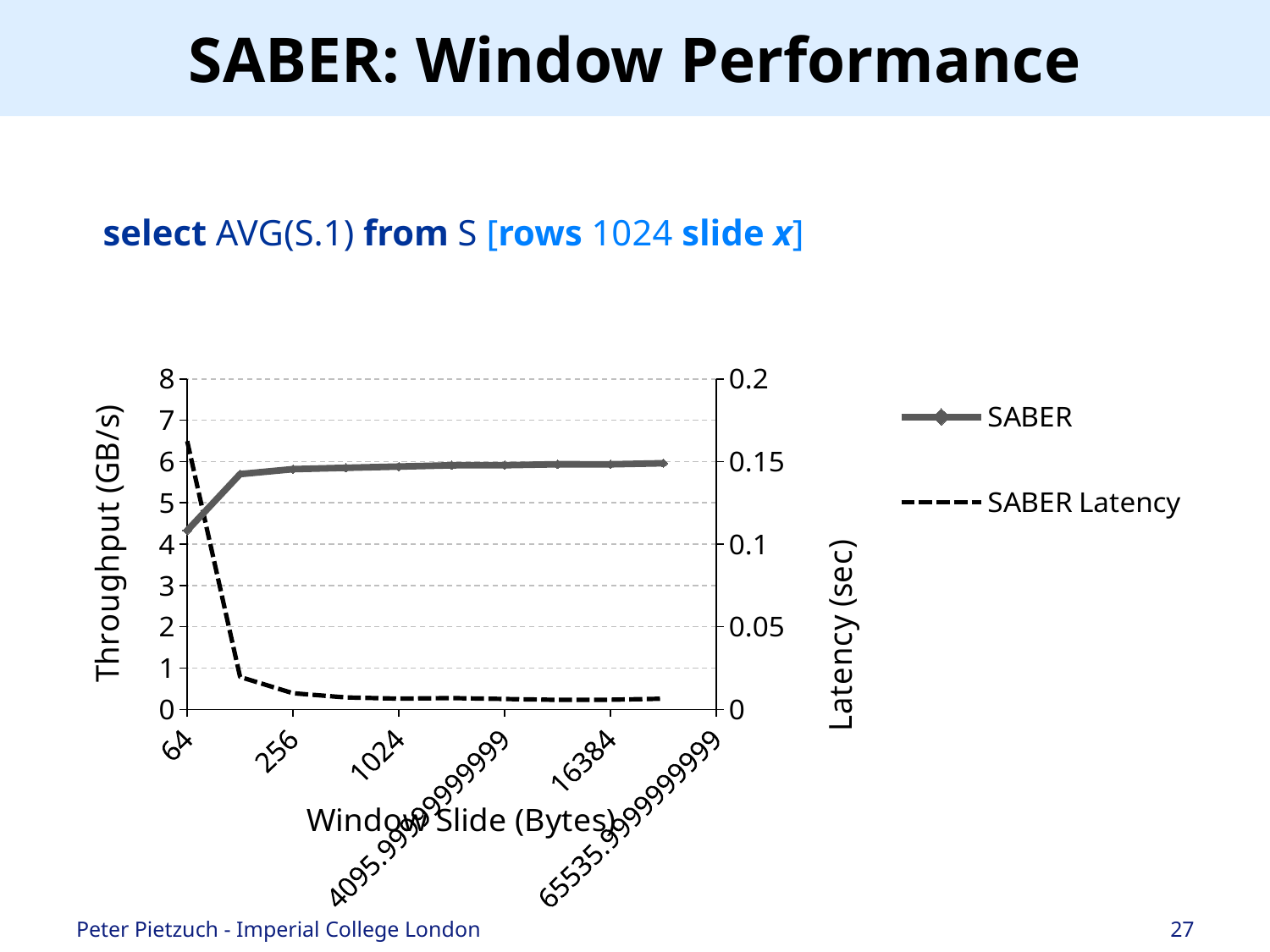
What is the title of the x axis? Window Slide (Bytes) Is the SABER throughput at a window slide of 64 greater or less than 4 GB/s? greater What kind of chart is shown on the slide? line chart At which window slide is the SABER Latency highest? 64 Is the SABER Latency at a window slide of 64 greater or less than 0.15 sec? greater Is the SABER Latency at a window slide of 256 greater or less than 0.05 sec? less At which window slide is the SABER throughput lowest? 64 What are the two series named in the legend? SABER and SABER Latency How many series does the legend list? 2 Does the SABER Latency rise or fall as the window slide increases from 64 to 256? fall